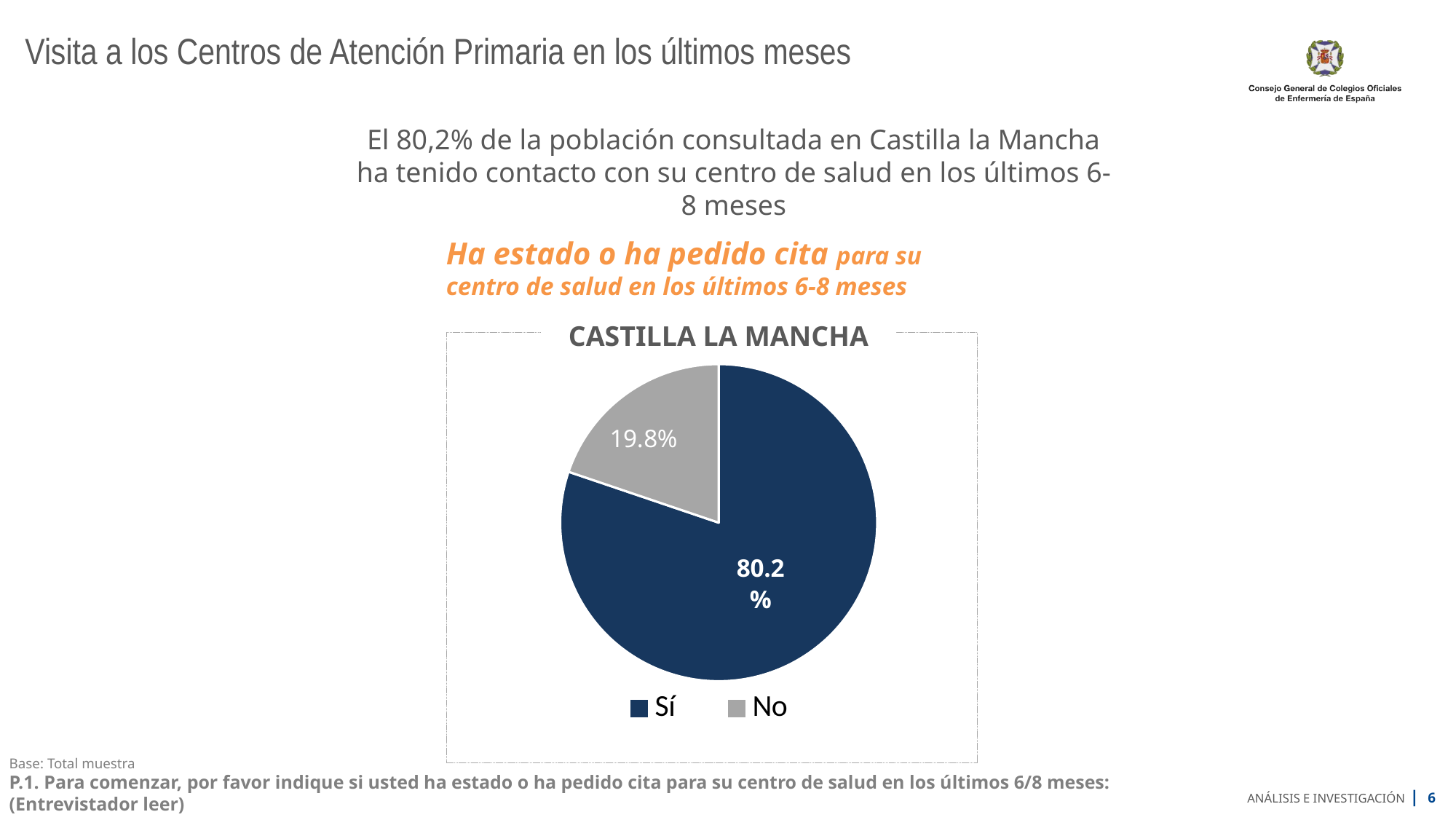
How many entries does the legend list? 2 What is the difference in percentage points between the 'Sí' and 'No' slices? 60.4 Which category has the largest share of the pie? Sí Which slice is larger, 'Sí' or 'No'? Sí What share of the pie does the 'Sí' slice represent? 80.2% What is the title of the chart? CASTILLA LA MANCHA What colour is the 'No' slice? Grey What percentage of the pie corresponds to 'No'? 19.8% What percentage of the pie corresponds to 'Sí'? 80.2% Which category has the smallest share of the pie? No How many slices does the pie chart have? 2 What type of chart is shown on the slide? Pie chart